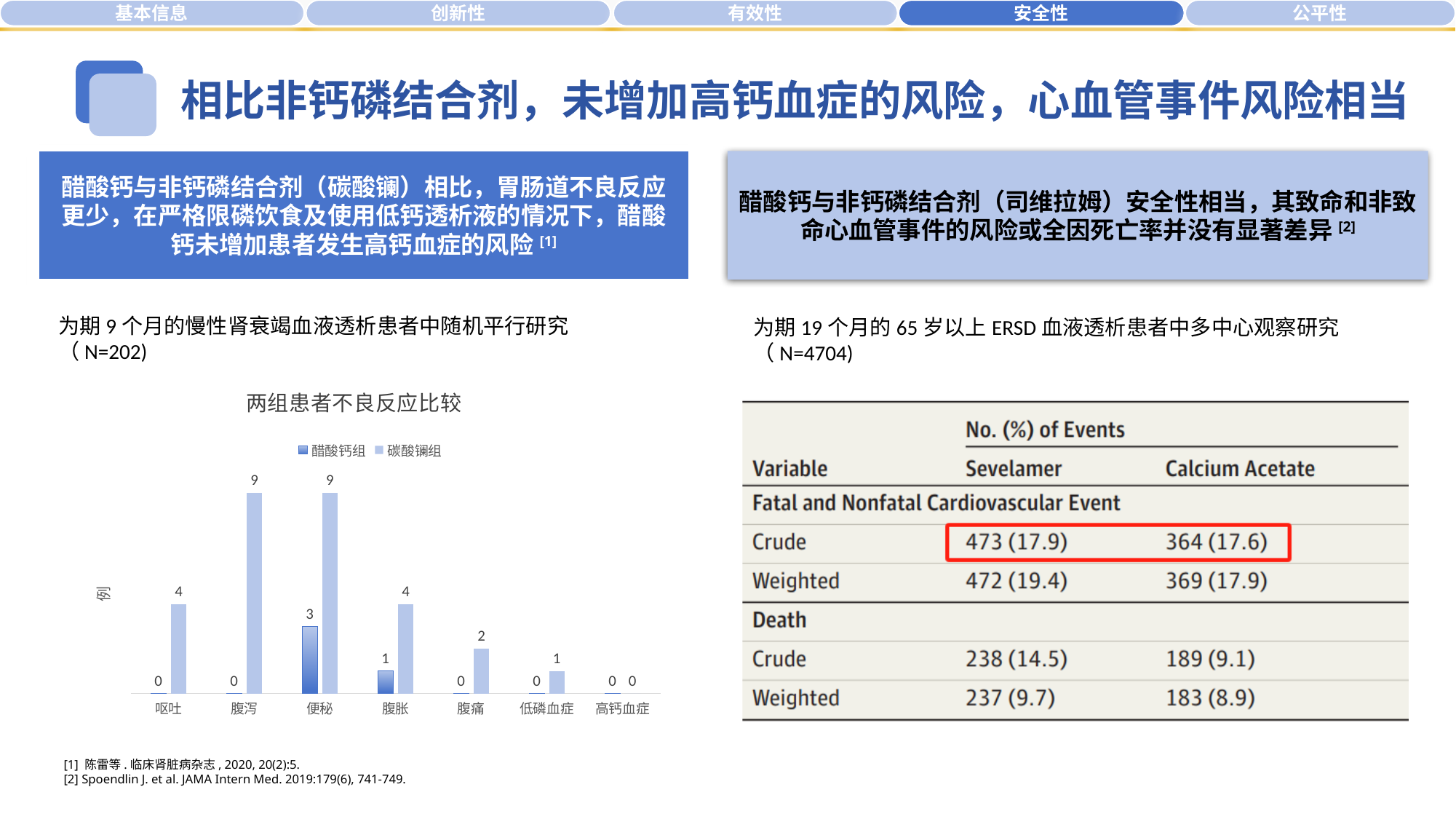
In the bar chart "两组患者不良反应比较", how many adverse reaction categories are shown on the x axis? 7 In the bar chart "两组患者不良反应比较", what is the value for 碳酸镧组 in the 腹泻 category? 9 What kind of chart is "两组患者不良反应比较"? bar chart In the bar chart "两组患者不良反应比较", what is the label of the y axis? 例 In the bar chart "两组患者不良反应比较", how many series does the legend list? 2 In the bar chart "两组患者不良反应比较", which category has the highest value for 醋酸钙组? 便秘 In the bar chart "两组患者不良反应比较", which category has the lowest value for 碳酸镧组? 高钙血症 In the bar chart "两组患者不良反应比较", what is the difference between 碳酸镧组 and 醋酸钙组 in the 便秘 category? 6 In the bar chart "两组患者不良反应比较", what is the value for 碳酸镧组 in the 腹痛 category? 2 In the bar chart "两组患者不良反应比较", what is the value for 醋酸钙组 in the 腹胀 category? 1 In the bar chart "两组患者不良反应比较", what is the value for 醋酸钙组 in the 便秘 category? 3 In the bar chart "两组患者不良反应比较", which series has the larger value in the 呕吐 category? 碳酸镧组